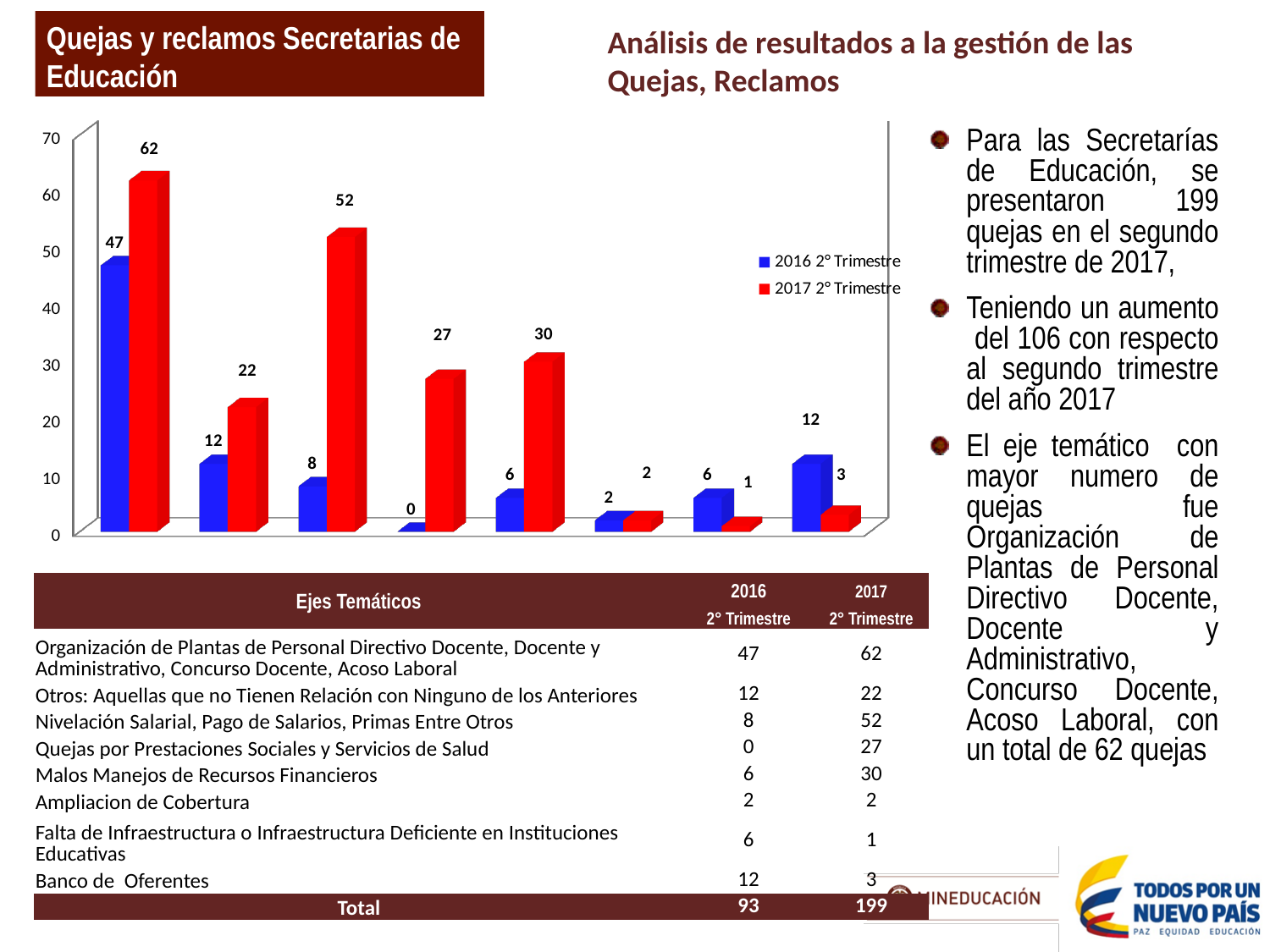
What is the lowest 2017 2° Trimestre value shown in the chart? 1 How many groups of bars (categories) are plotted in the chart? 8 Which category has the highest 2017 2° Trimestre bar? Organización de Plantas de Personal Directivo Docente, Docente y Administrativo, Concurso Docente, Acoso Laboral (62) What is the 2016 2° Trimestre value for the fourth category (Quejas por Prestaciones Sociales y Servicios de Salud)? 0 For Malos Manejos de Recursos Financieros, which series has the larger value, 2016 2° Trimestre or 2017 2° Trimestre? 2017 2° Trimestre What is the 2017 2° Trimestre value for the first category (Organización de Plantas de Personal Directivo Docente, Docente y Administrativo, Concurso Docente, Acoso Laboral)? 62 Is the 2017 2° Trimestre value for Nivelación Salarial, Pago de Salarios, Primas Entre Otros greater or less than 50? greater What are the two series named in the chart legend? 2016 2° Trimestre and 2017 2° Trimestre What is the 2016 2° Trimestre value for the third category (Nivelación Salarial, Pago de Salarios, Primas Entre Otros)? 8 What is the difference between the 2017 and 2016 values for the first category (Organización de Plantas de Personal Directivo Docente)? 15 How many series does the chart legend list? 2 What kind of chart is shown on the slide? bar chart